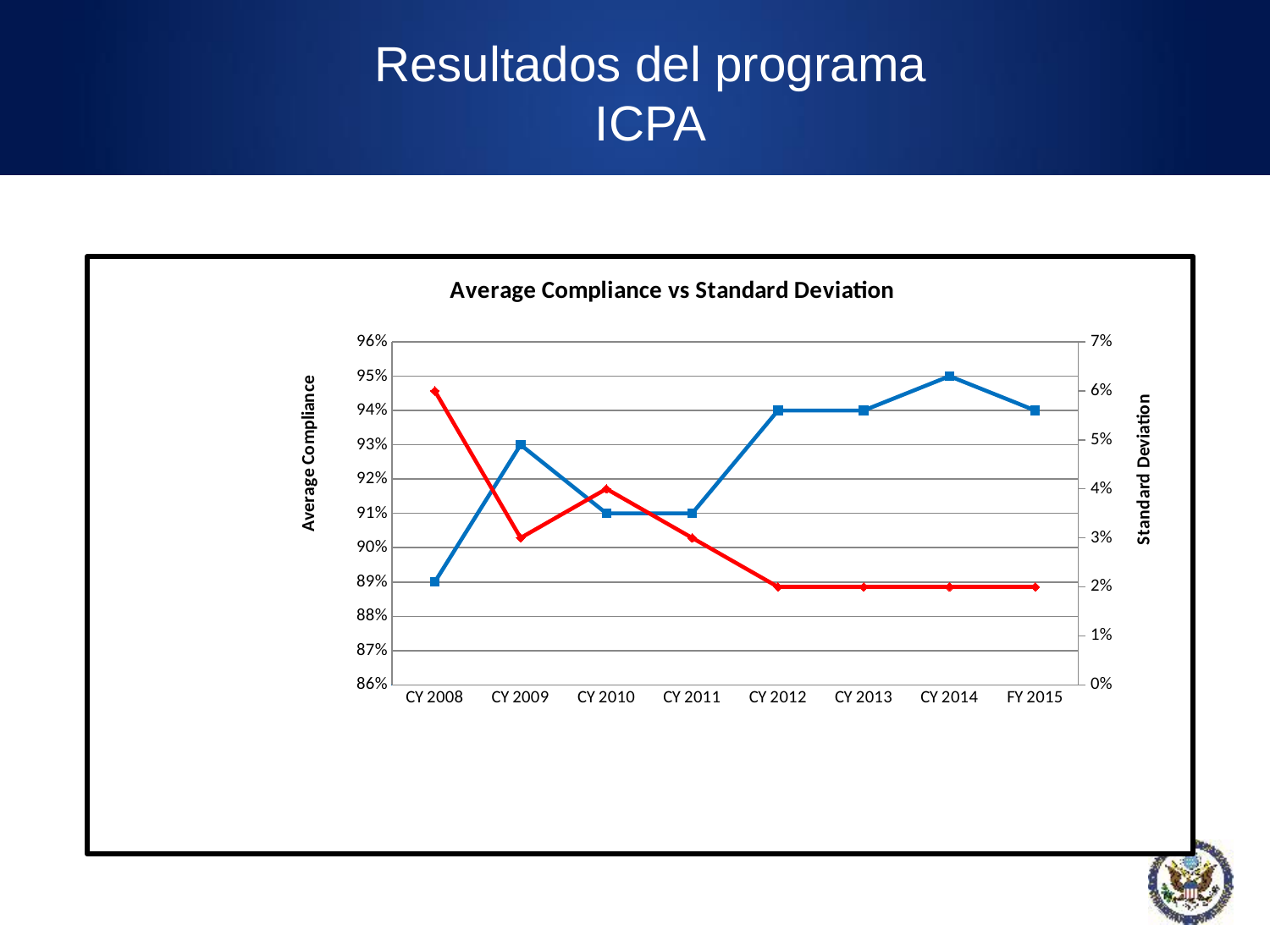
Which period has the higher Average Compliance, CY 2009 or CY 2010? CY 2009 What is the Average Compliance value for CY 2014? 95% What is the Average Compliance value for FY 2015? 94% In which period is Average Compliance highest? CY 2014 What type of chart is shown on the slide? Line chart How many time periods are plotted along the x axis? 8 Is the Standard Deviation value for CY 2008 greater or less than 5%? greater What is the title of the chart? Average Compliance vs Standard Deviation What is the Average Compliance value for CY 2008? 89% In which period is Average Compliance lowest? CY 2008 By how many percentage points does Average Compliance in CY 2014 exceed that in CY 2008? 6 percentage points Does the Standard Deviation line generally rise or fall from CY 2008 to FY 2015? Fall